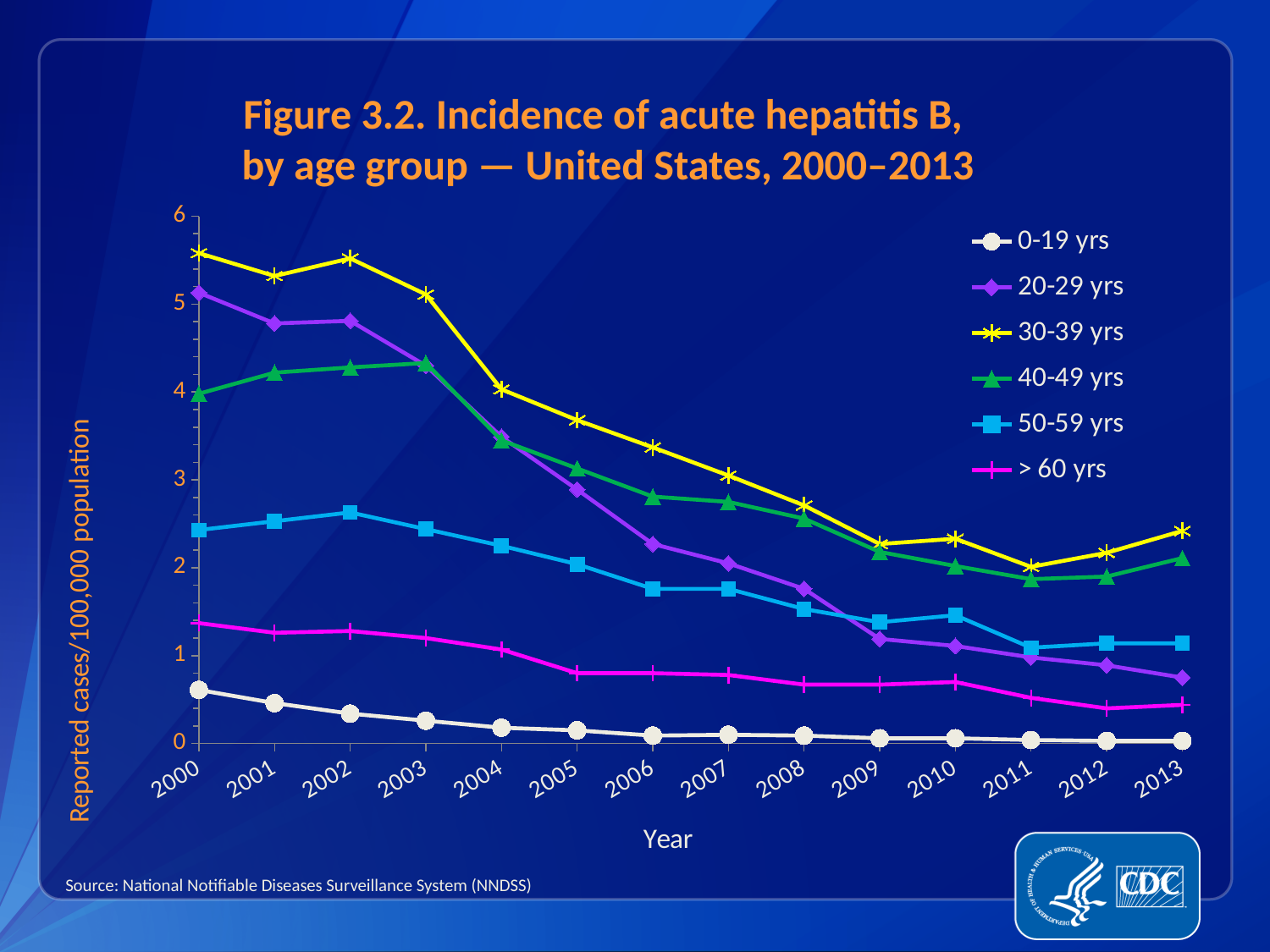
How many age-group series does the legend list? 6 In 2006, which had the larger incidence: 20-29 yrs or 40-49 yrs? 40-49 yrs Which age group had the highest incidence in 2000? 30-39 yrs How many years are plotted along the x axis? 14 What kind of chart is shown on the slide? line chart Is the value for 30-39 yrs in 2000 greater or less than 5? greater Which age group had the lowest incidence in 2000? 0-19 yrs What is the label of the y axis? Reported cases/100,000 population Is the value for 20-29 yrs in 2013 greater or less than 1? less Which age group had the highest incidence in 2013? 30-39 yrs Is the value for 50-59 yrs in 2002 greater or less than 2? greater Does the incidence for the 30-39 yrs group rise or fall from 2000 to 2013? fall